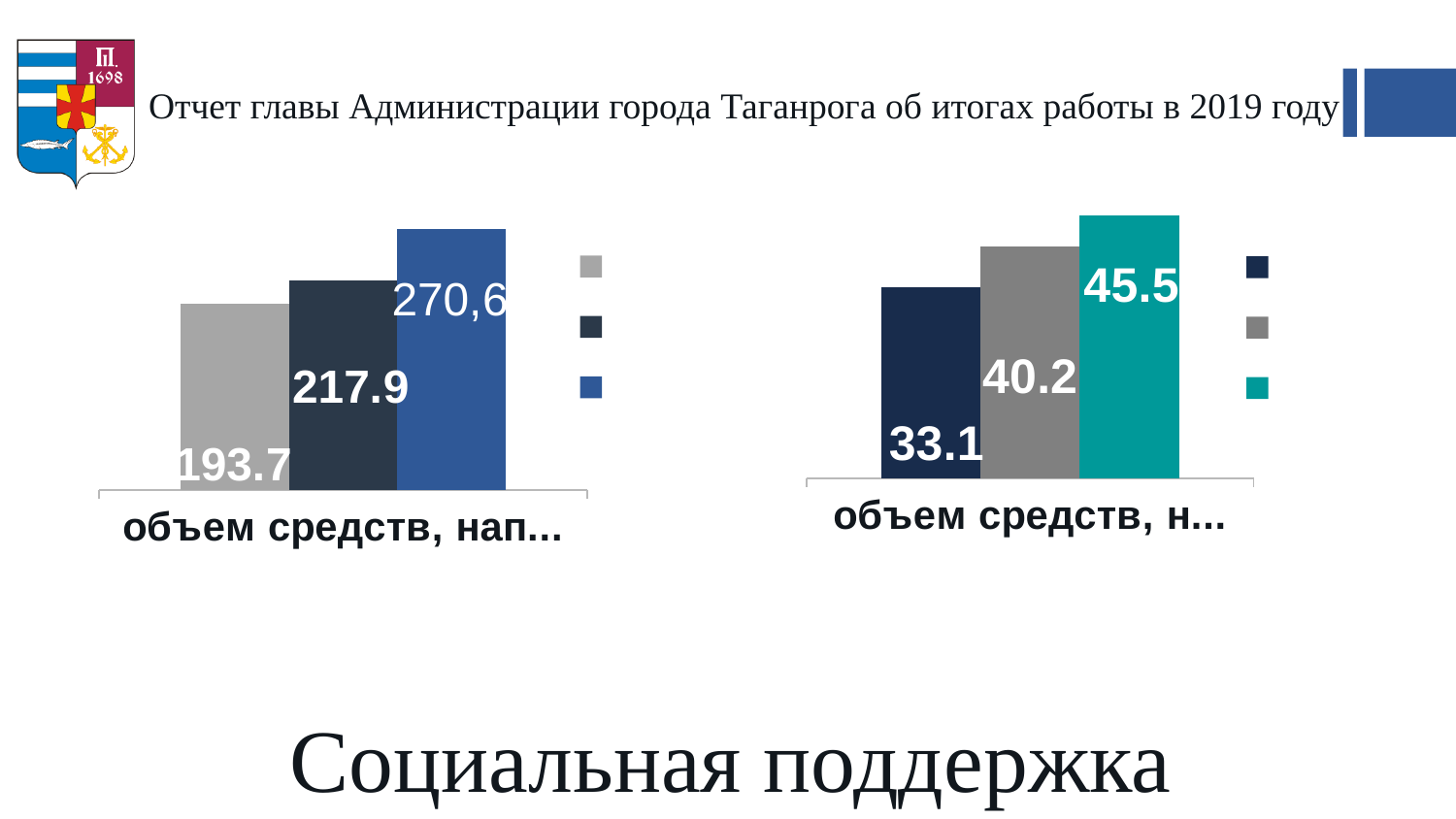
In the left chart, what is the highest value shown? 270,6 What type of chart is the left chart? bar chart In the left chart, what value is shown on the blue (rightmost) bar? 270,6 In the right chart, what value is shown on the teal (rightmost) bar? 45.5 In the left chart, what value is shown on the dark navy (middle) bar? 217.9 In the right chart, what is the difference between the teal bar (45.5) and the dark navy bar (33.1)? 12.4 In the right chart, what is the lowest value shown? 33.1 In the right chart, how many bars are plotted? 3 In the left chart, what is the difference between the dark navy bar (217.9) and the light grey bar (193.7)? 24.2 In the left chart, what value is shown on the light grey bar? 193.7 In the left chart, do the bar values rise or fall from left to right? rise In the right chart, what value is shown on the grey (middle) bar? 40.2